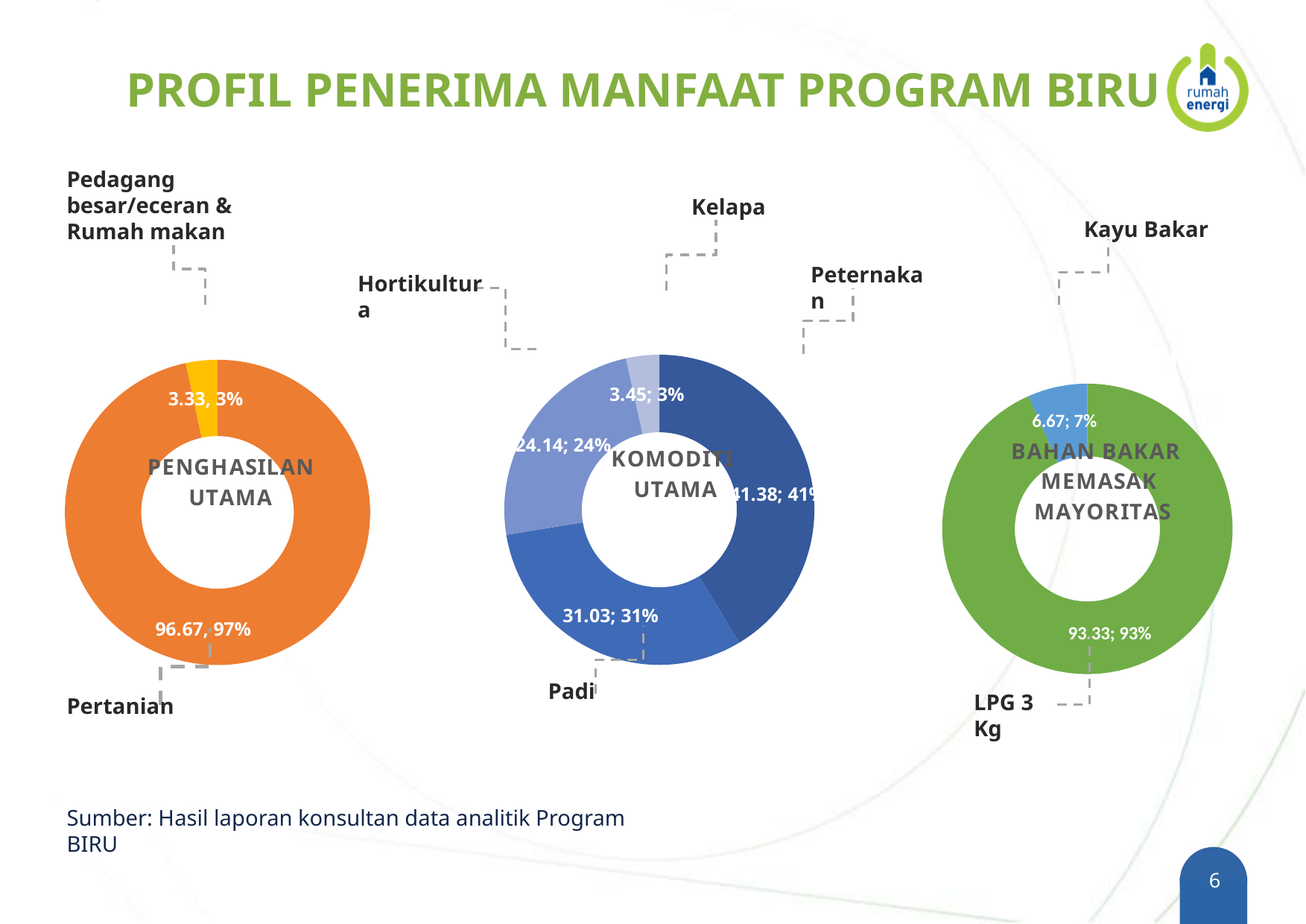
In the KOMODITI UTAMA chart, what is the value shown for Hortikultura? 24.14; 24% In the KOMODITI UTAMA chart, what is the value shown for Padi? 31.03; 31% In the PENGHASILAN UTAMA chart, what share does Pedagang besar/eceran & Rumah makan have? 3% In the KOMODITI UTAMA chart, what is the difference in percentage points between Peternakan and Padi? 10 In the BAHAN BAKAR MEMASAK MAYORITAS chart, what is the value shown for Kayu Bakar? 6.67; 7% How many donut charts are shown on the slide? 3 In the KOMODITI UTAMA chart, which category has the smallest share? Kelapa What kind of chart is the PENGHASILAN UTAMA chart on the left? Pie chart (donut) In the PENGHASILAN UTAMA chart, what is the value shown for Pertanian? 96.67, 97% How many slices does the KOMODITI UTAMA chart in the middle have? 4 In the KOMODITI UTAMA chart, which category has the largest share? Peternakan In the BAHAN BAKAR MEMASAK MAYORITAS chart, which is larger: LPG 3 Kg or Kayu Bakar? LPG 3 Kg